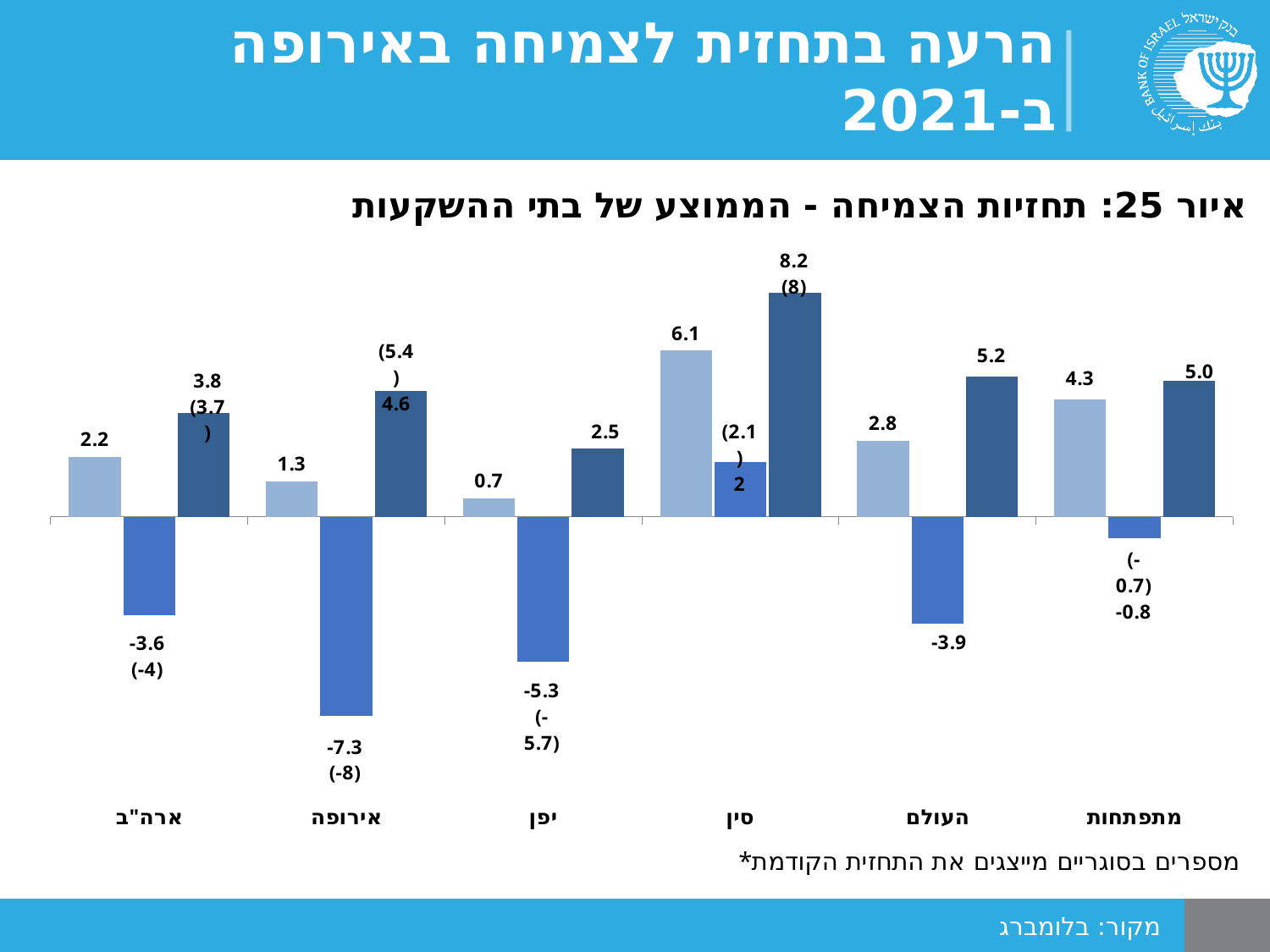
What is the value of the dark blue bar for העולם (World)? 5.2 What is the value shown in parentheses next to the medium blue bar for ארה"ב? (-4) Which is larger: the light blue bar for ארה"ב or the light blue bar for אירופה? ארה"ב What is the difference between the dark blue bar for סין (8.2) and the dark blue bar for יפן (2.5)? 5.7 How many categories (regions) are shown on the x axis of the chart? 6 Which category has the highest dark blue bar? סין What is the value of the dark blue bar for מתפתחות (Emerging)? 5.0 What type of chart is shown on the slide? bar chart What is the value of the light blue bar for סין (China)? 6.1 What is the title of the chart? איור 25: תחזיות הצמיחה - הממוצע של בתי ההשקעות What is the value of the medium blue bar for אירופה (Europe)? -7.3 Which category has the lowest medium blue bar? אירופה